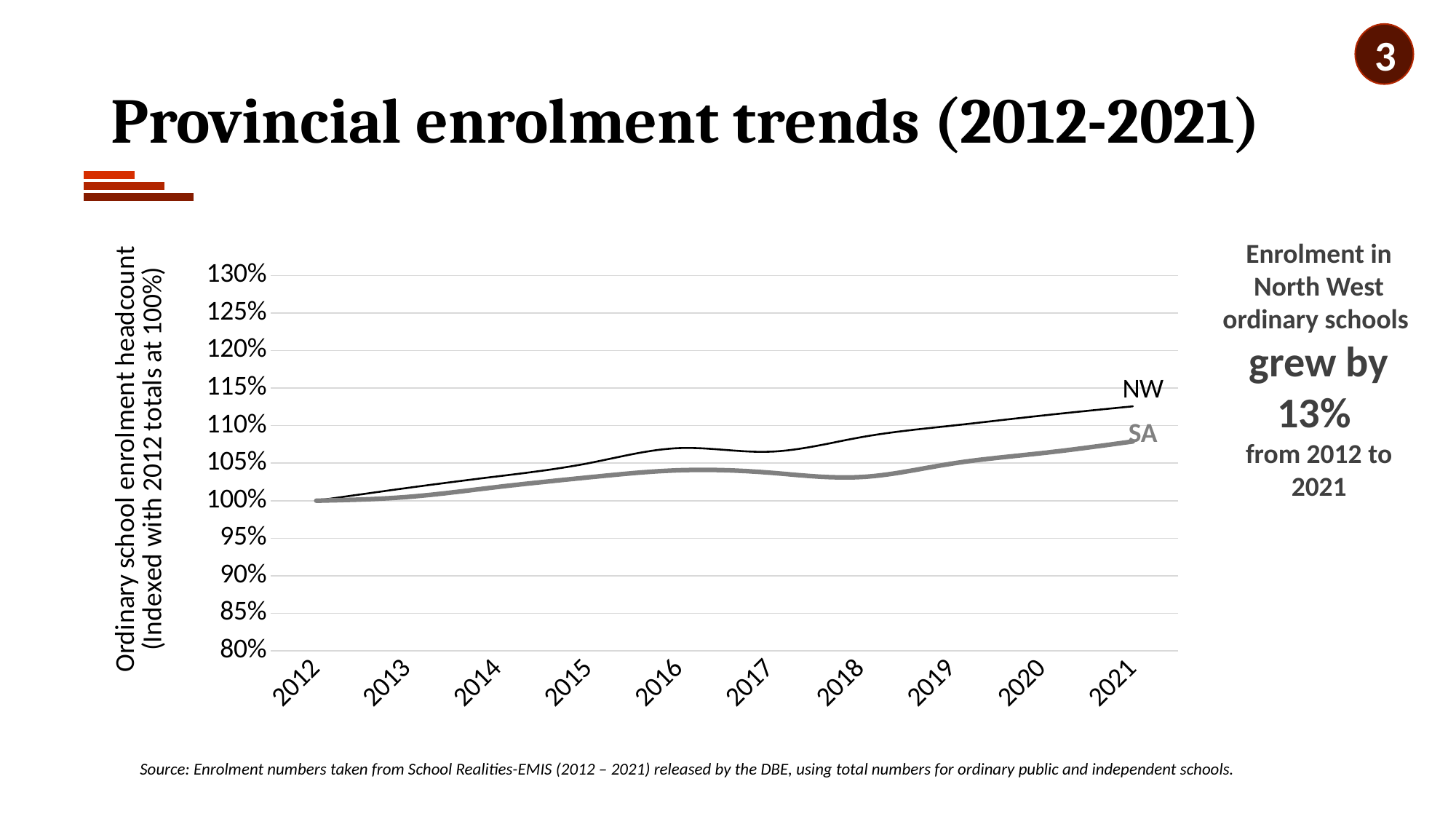
Which series is drawn with the thick grey line? SA How many years are shown along the x axis of the chart? 10 What is the indexed value for SA in 2012? 100% Is the value for SA in 2018 greater or less than 105%? less Is the value for NW in 2016 greater or less than 105%? greater Do the values for NW generally rise or fall from 2012 to 2021? rise What kind of chart is shown on the slide? line chart Is the value for NW in 2021 greater or less than 110%? greater How many series are plotted on the chart? 2 What is the indexed value for NW in 2012? 100% Which series has the higher value in 2021, NW or SA? NW